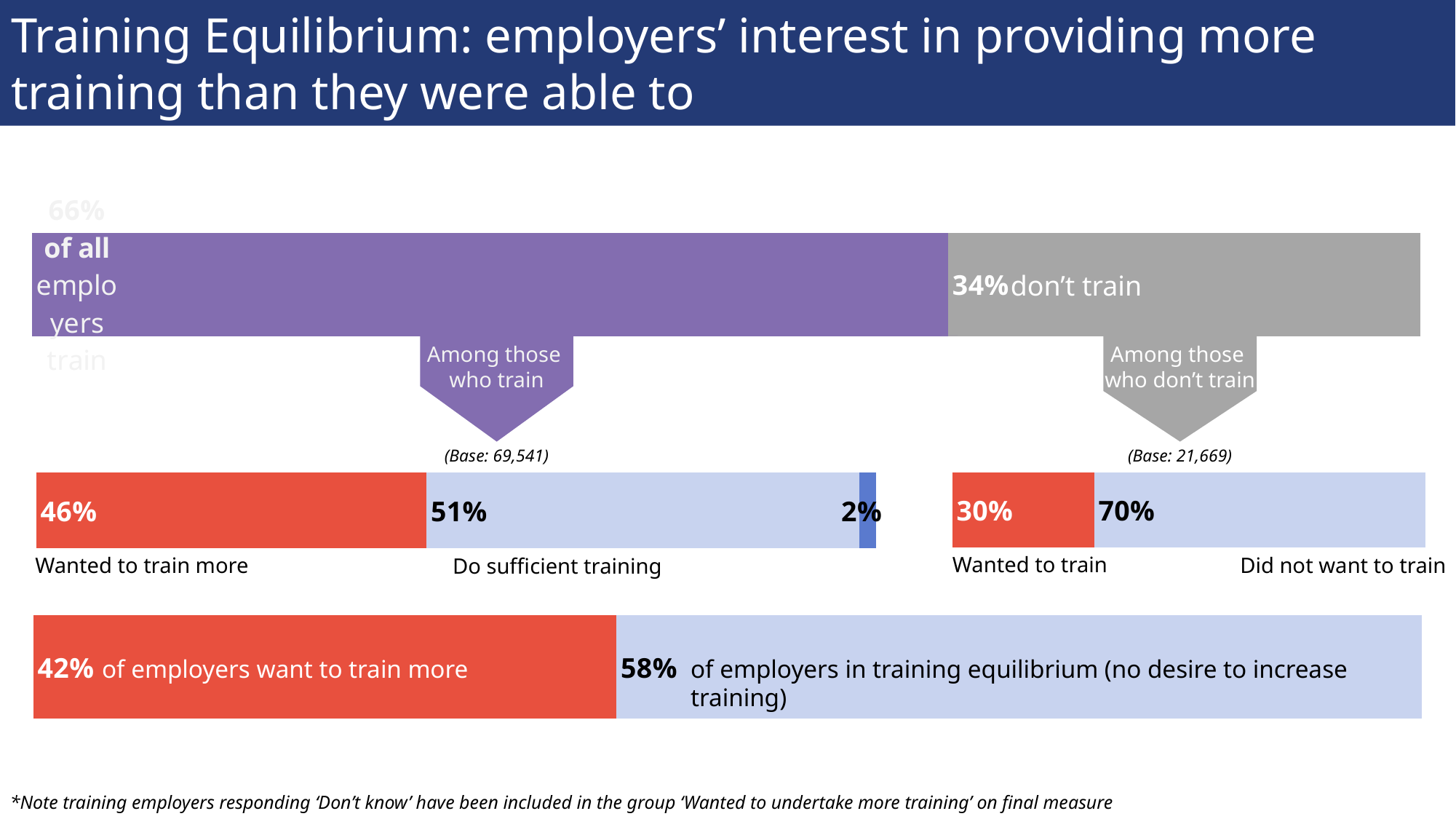
In the 'Among those who train' bar, which segment is larger: 'Wanted to train more' or 'Do sufficient training'? Do sufficient training In the 'Among those who don't train' bar, what percentage did not want to train? 70% What kind of chart is used to show the 'Among those who don't train' breakdown? Stacked bar chart In the top bar showing all employers, what percentage of employers don't train? 34% In the bottom bar, what percentage of employers are in training equilibrium? 58% In the top bar showing all employers, what percentage of employers train? 66% What is the base (number of respondents) for the 'Among those who train' bar? 69,541 In the 'Among those who train' bar, what percentage wanted to train more? 46% In the 'Among those who don't train' bar, what is the difference between 'Did not want to train' and 'Wanted to train'? 40% In the bottom bar, what percentage of employers want to train more? 42% In the 'Among those who train' bar, what percentage do sufficient training? 51% In the 'Among those who don't train' bar, what percentage wanted to train? 30%